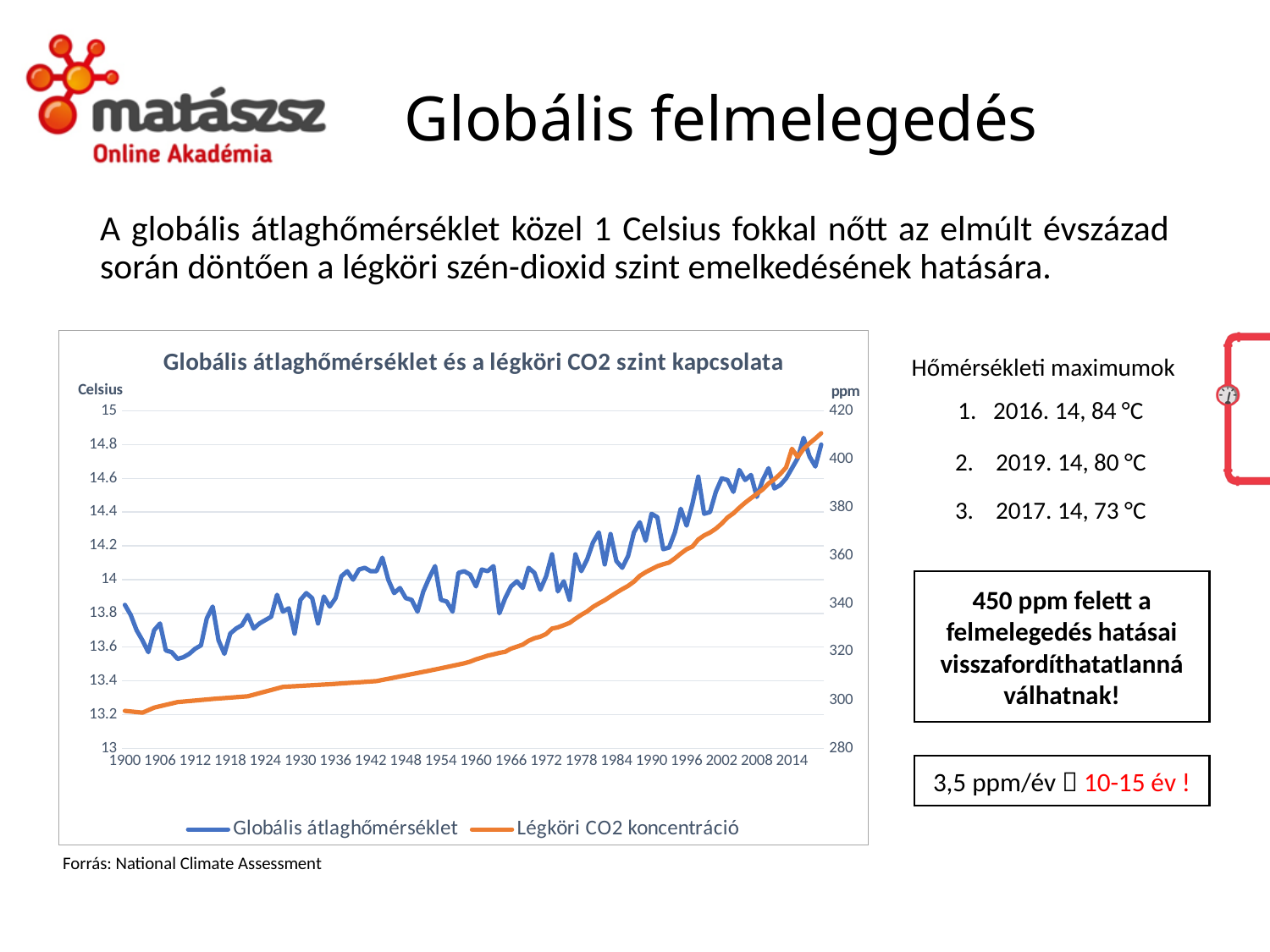
Which is larger for Légköri CO2 koncentráció: the value in 1900 or the value in 2014? 2014 What are the two series named in the chart's legend? Globális átlaghőmérséklet and Légköri CO2 koncentráció Is the Légköri CO2 koncentráció value for 1930 greater or less than 320 ppm? less Is the Globális átlaghőmérséklet value for 1950 greater or less than 14.2 Celsius? less What kind of chart is shown on the slide? line chart Is the Légköri CO2 koncentráció value for 2014 greater or less than 380 ppm? greater What is the title of the chart? Globális átlaghőmérséklet és a légköri CO2 szint kapcsolata Which is larger for Globális átlaghőmérséklet: the value in 1912 or the value in 2008? 2008 Overall, does the Globális átlaghőmérséklet series rise or fall from 1900 to 2014? rise How many series does the chart's legend list? 2 Does the Légköri CO2 koncentráció series rise or fall from 1900 to 2014? rise